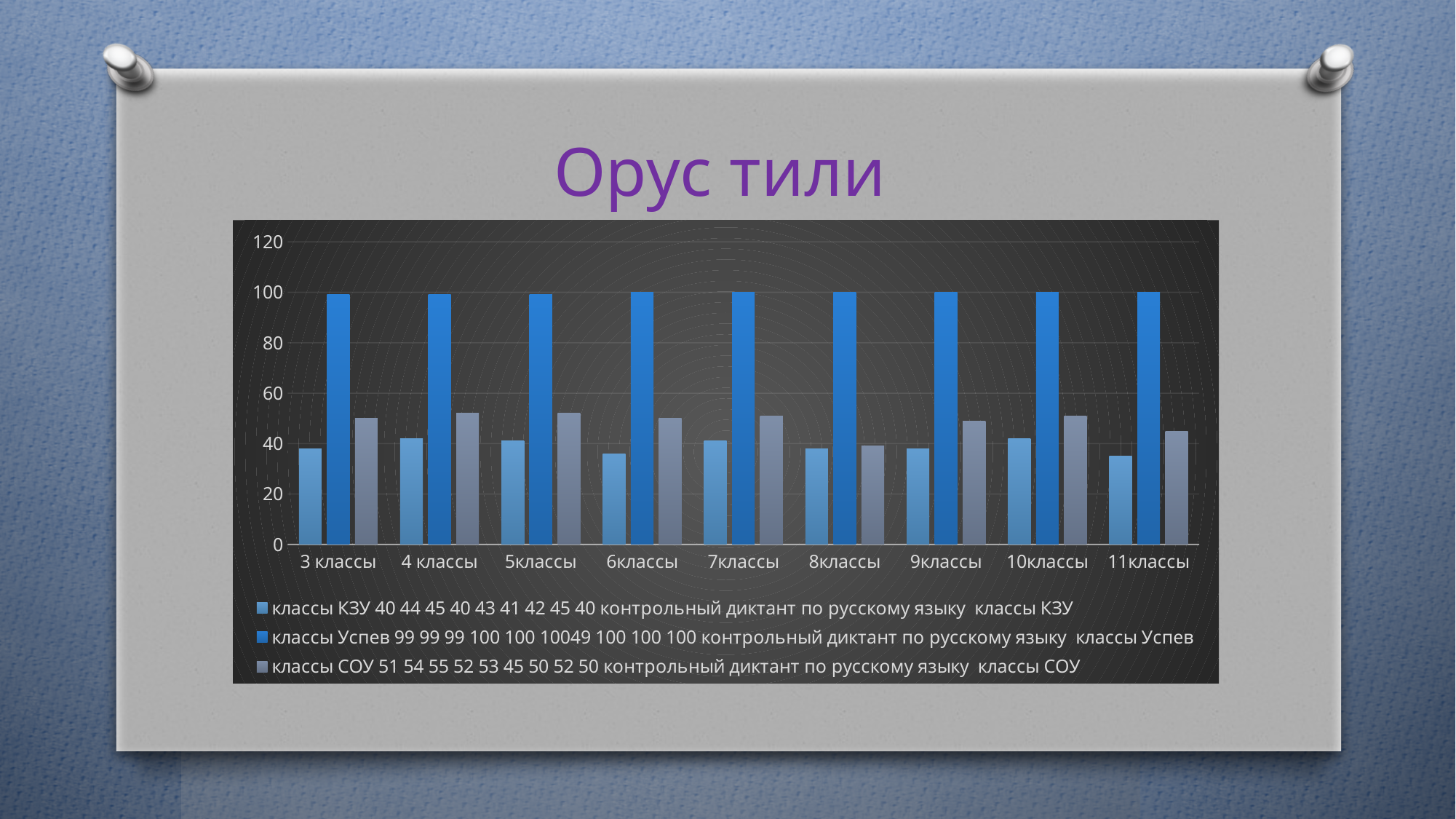
Which series has the highest value at 8классы? классы Успев For классы КЗУ, which is larger: 4 классы or 6классы? 4 классы What kind of chart is shown on the slide? bar chart At 7классы, which is larger: классы СОУ or классы КЗУ? классы СОУ What is the title of the slide above the chart? Орус тили How many class categories are shown along the x axis? 9 Which series has the lowest value at 6классы? классы КЗУ Is the value for классы КЗУ at 11классы greater or less than 40? less Is the value for классы СОУ at 4 классы greater or less than 40? greater Is the value for классы СОУ at 5классы greater or less than 60? less How many series does the legend list? 3